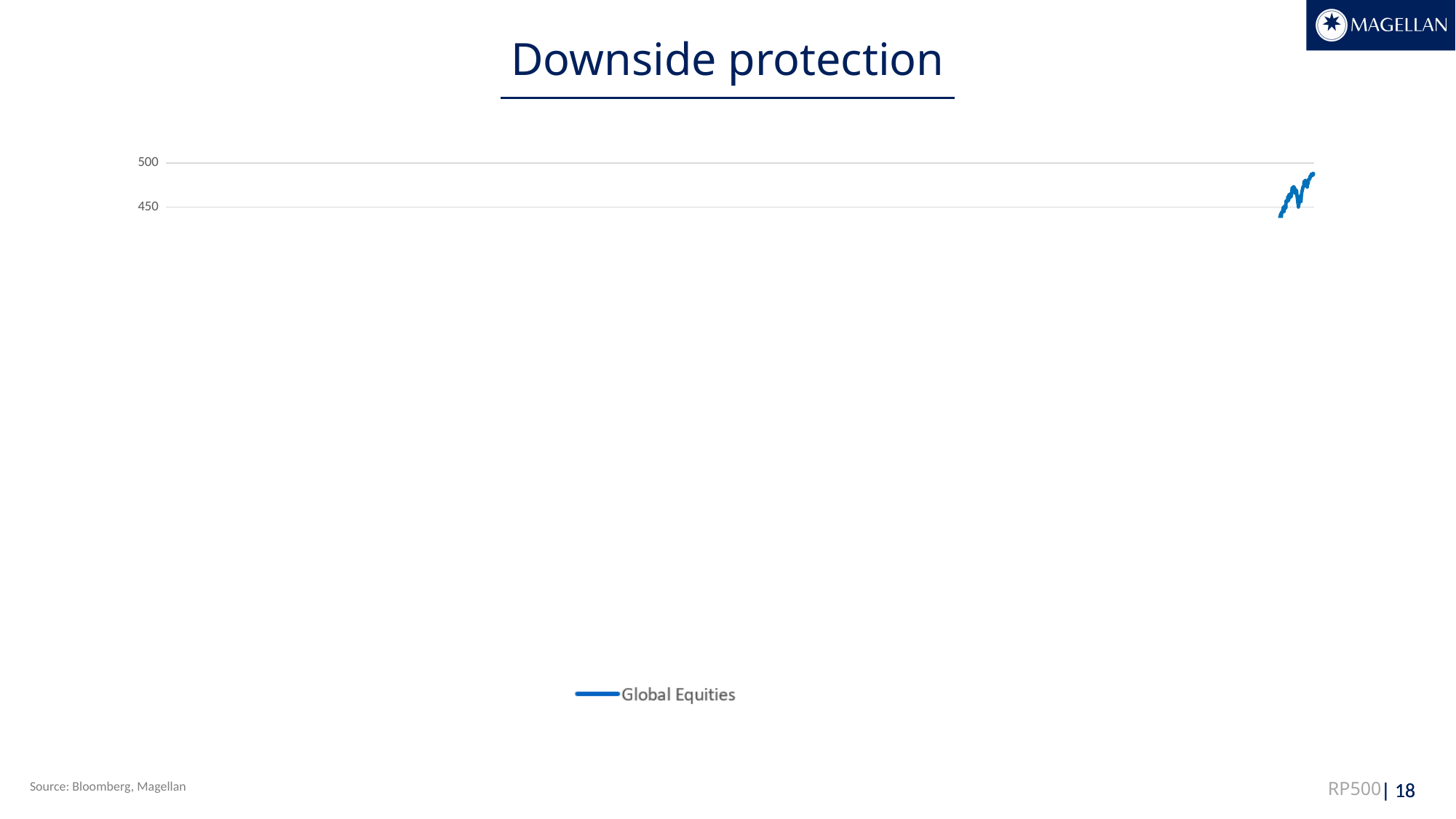
What kind of chart is shown on the slide? line chart Does the Global Equities line rise or fall from left to right over the visible segment? rise What series name is shown in the chart's legend? Global Equities How many series does the chart's legend list? 1 What is the title of the slide containing the chart? Downside protection Is the plotted value for Global Equities at the right end of the line greater or less than 500? less